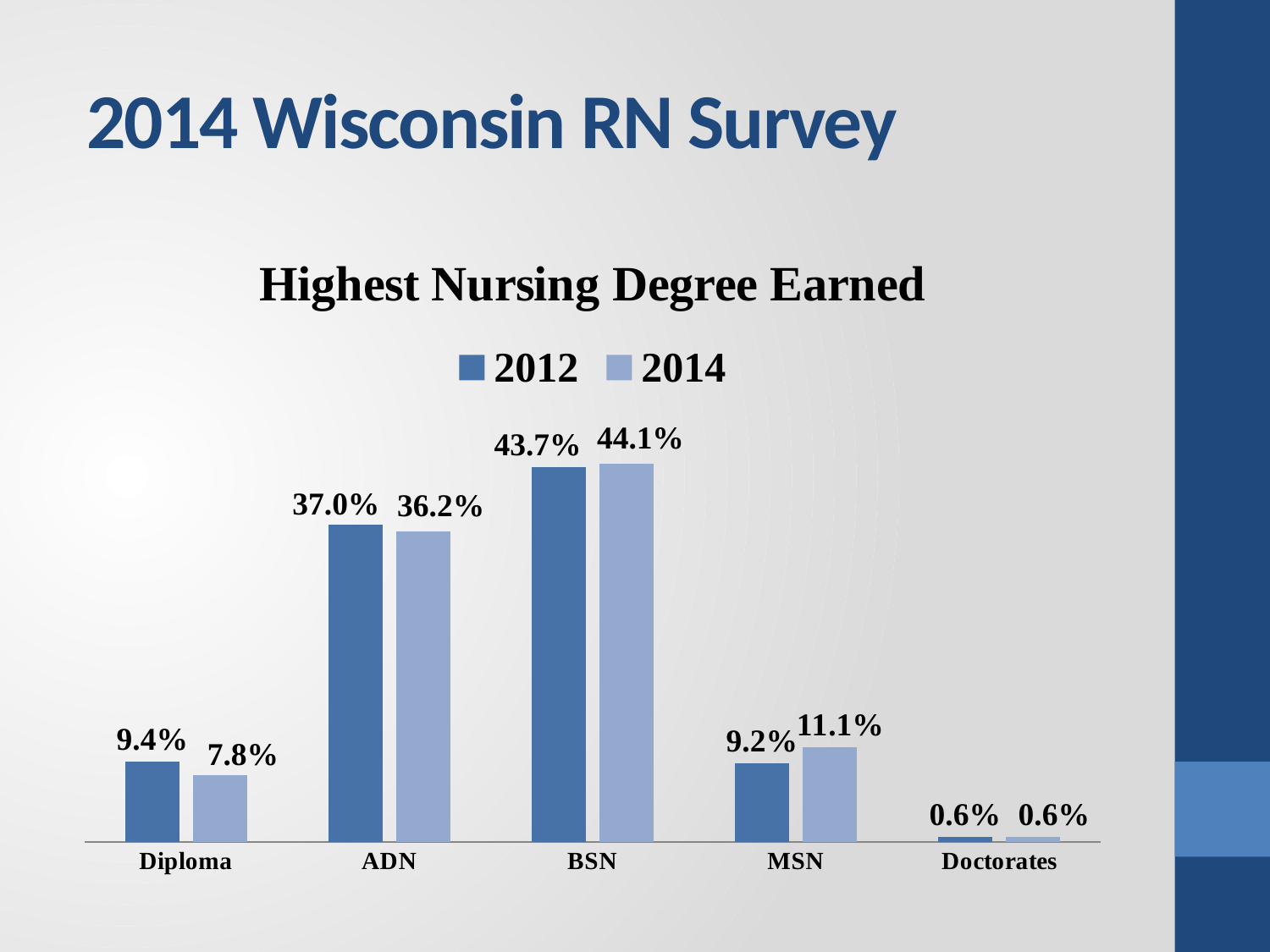
How many degree categories are shown on the x axis? 5 Which category has the lowest 2014 value? Doctorates Which is larger for ADN, the 2012 value or the 2014 value? 2012 What is the 2012 value for Diploma? 9.4% What kind of chart is shown? Bar chart What is the 2014 value for MSN? 11.1% What is the title of the chart? Highest Nursing Degree Earned Which category has the highest 2012 value? BSN What is the 2012 value for ADN? 37.0% What is the 2014 value for BSN? 44.1% How many series does the legend list? 2 What is the difference between the 2014 and 2012 values for MSN? 1.9%